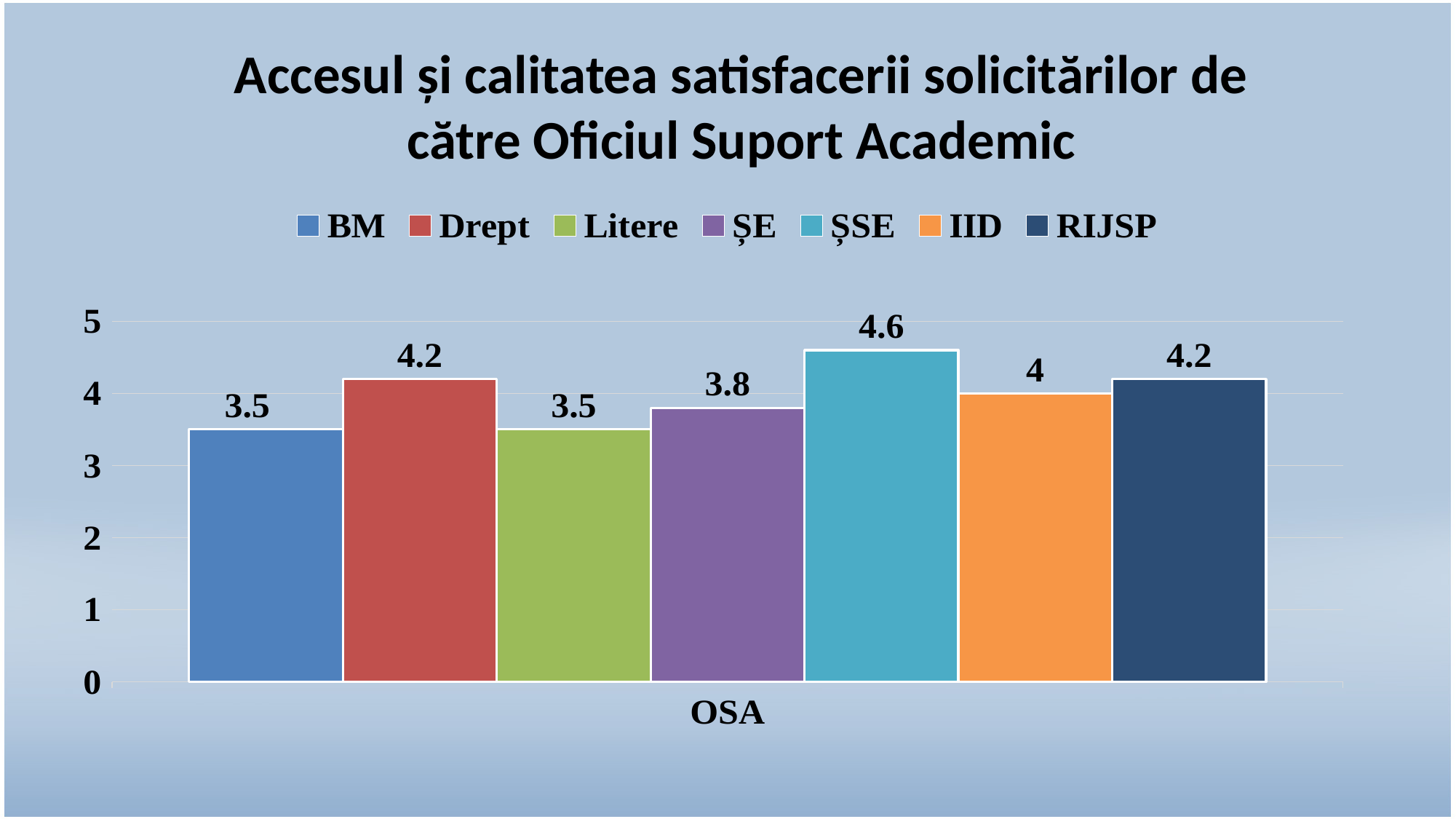
What is the value for BM? 3.5 What is the difference between the values for Drept and BM? 0.7 Which series has the highest value? ȘSE What is the value for ȘE? 3.8 How many series does the legend list? 7 Is the value for RIJSP greater or less than 4? greater What kind of chart is shown on the slide? bar chart What is the difference between the values for ȘSE and ȘE? 0.8 Which is larger, the value for IID or the value for Litere? IID What is the label on the x axis of the chart? OSA What is the value for IID? 4 What is the value for ȘSE? 4.6